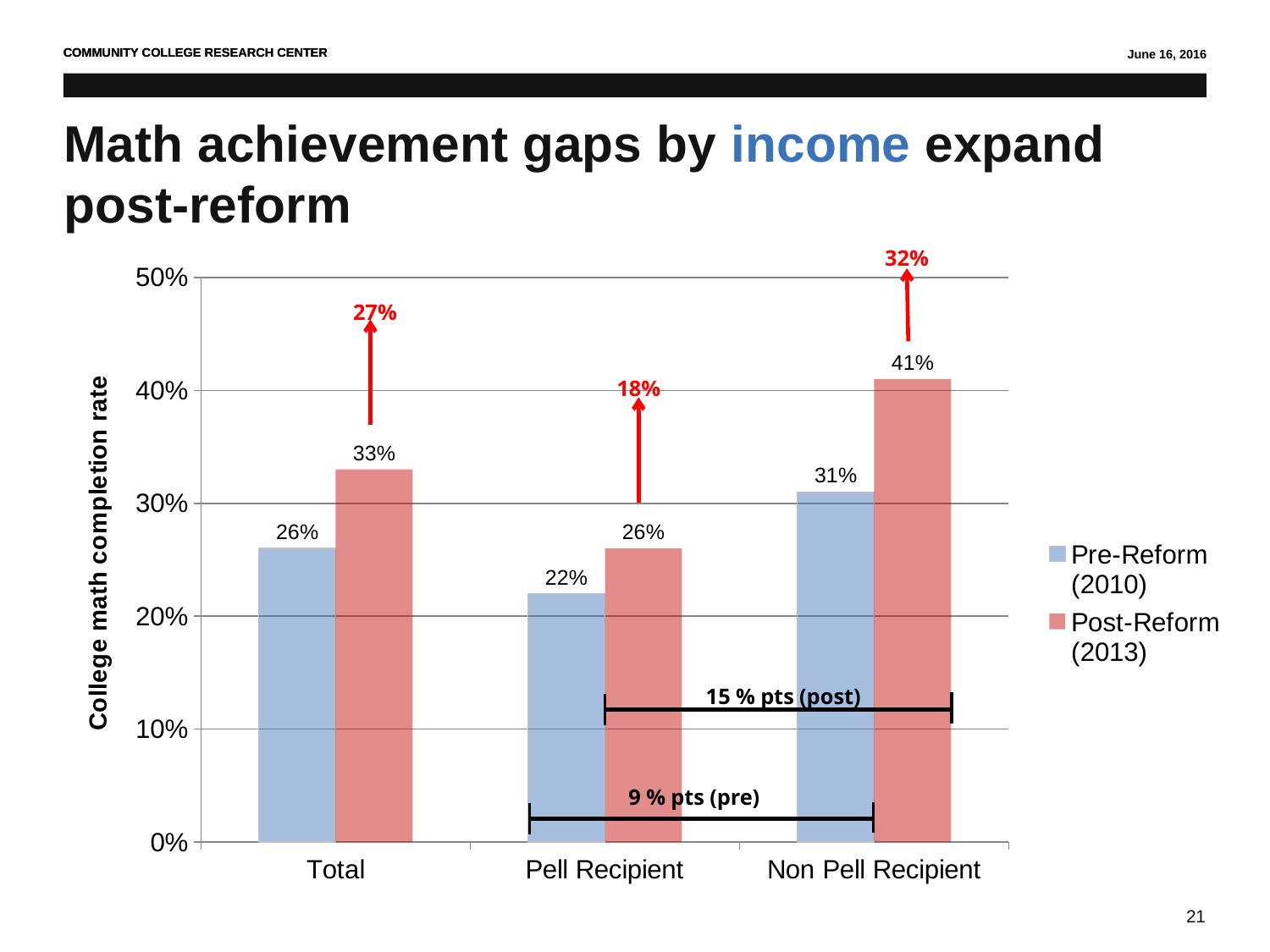
How many series does the legend list? 2 What is the Post-Reform (2013) value for the Total category? 33% Is the Post-Reform (2013) value for Total greater or less than 30%? greater What is the difference between the Post-Reform (2013) and Pre-Reform (2010) values for Non Pell Recipient? 10% Which category has the highest Post-Reform (2013) completion rate? Non Pell Recipient What kind of chart is shown on the slide? Bar chart What is the Pre-Reform (2010) college math completion rate for Pell Recipient? 22% How many categories are shown on the x axis? 3 Which is larger: the Pre-Reform (2010) value for Non Pell Recipient or the Post-Reform (2013) value for Pell Recipient? Pre-Reform (2010) value for Non Pell Recipient What is the Post-Reform (2013) college math completion rate for Non Pell Recipient? 41% What is the label of the y axis? College math completion rate Which category has the lowest Pre-Reform (2010) completion rate? Pell Recipient